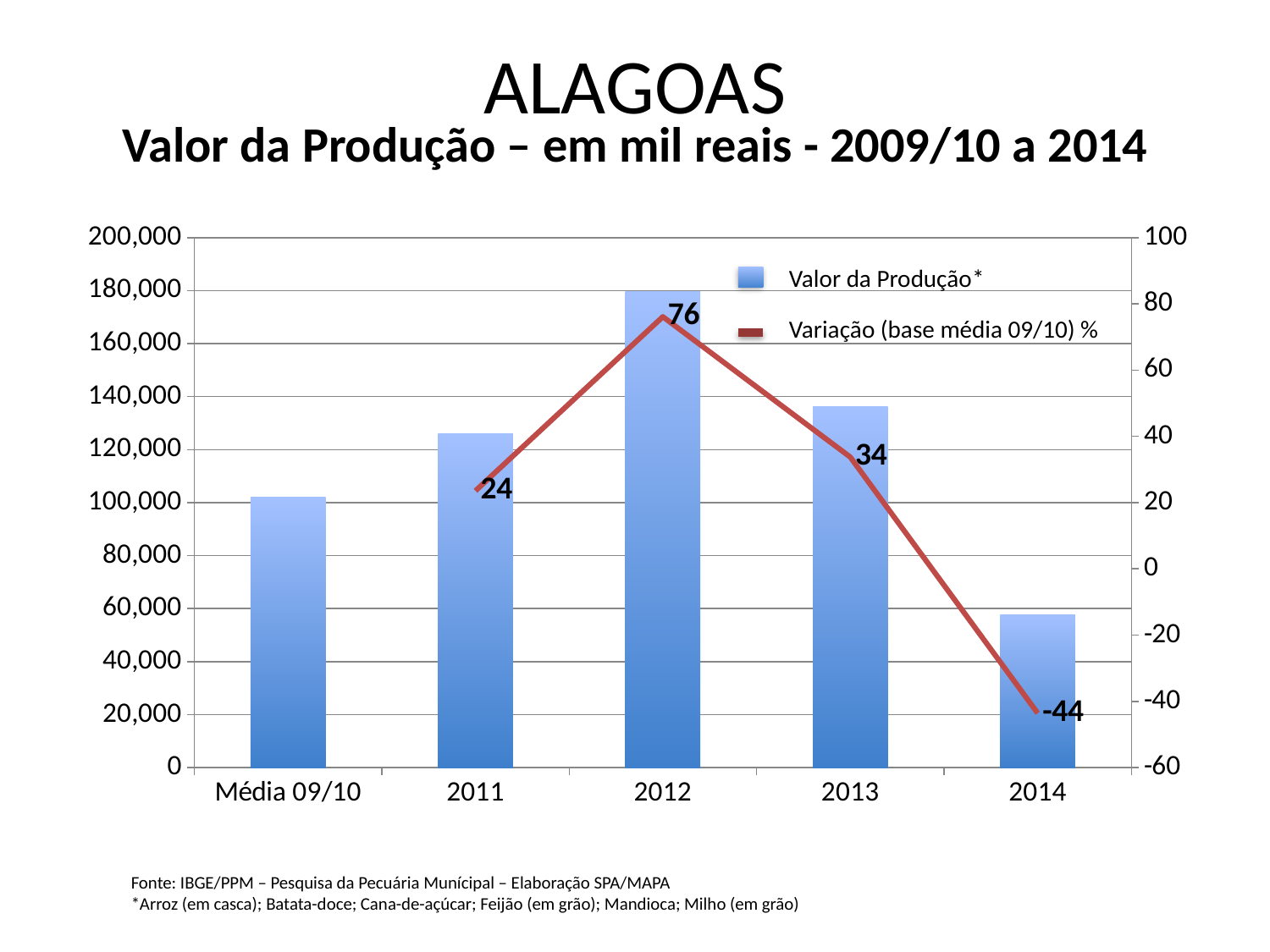
How many categories are shown on the x axis? 5 What is the Variação (base média 09/10) % value for 2011? 24 Which is larger, the Valor da Produção bar for 2011 or for Média 09/10? 2011 Which year has the highest Valor da Produção bar? 2012 Is the Valor da Produção bar for 2013 greater or less than 120,000? greater Is the Valor da Produção bar for 2014 greater or less than 80,000? less How many series does the legend list? 2 What is the Variação (base média 09/10) % value for 2012? 76 What is the difference between the Variação values for 2012 and 2013? 42 How does the Variação line change from 2012 to 2014? It falls What is the Variação (base média 09/10) % value for 2014? -44 Which category has the lowest Valor da Produção bar? 2014